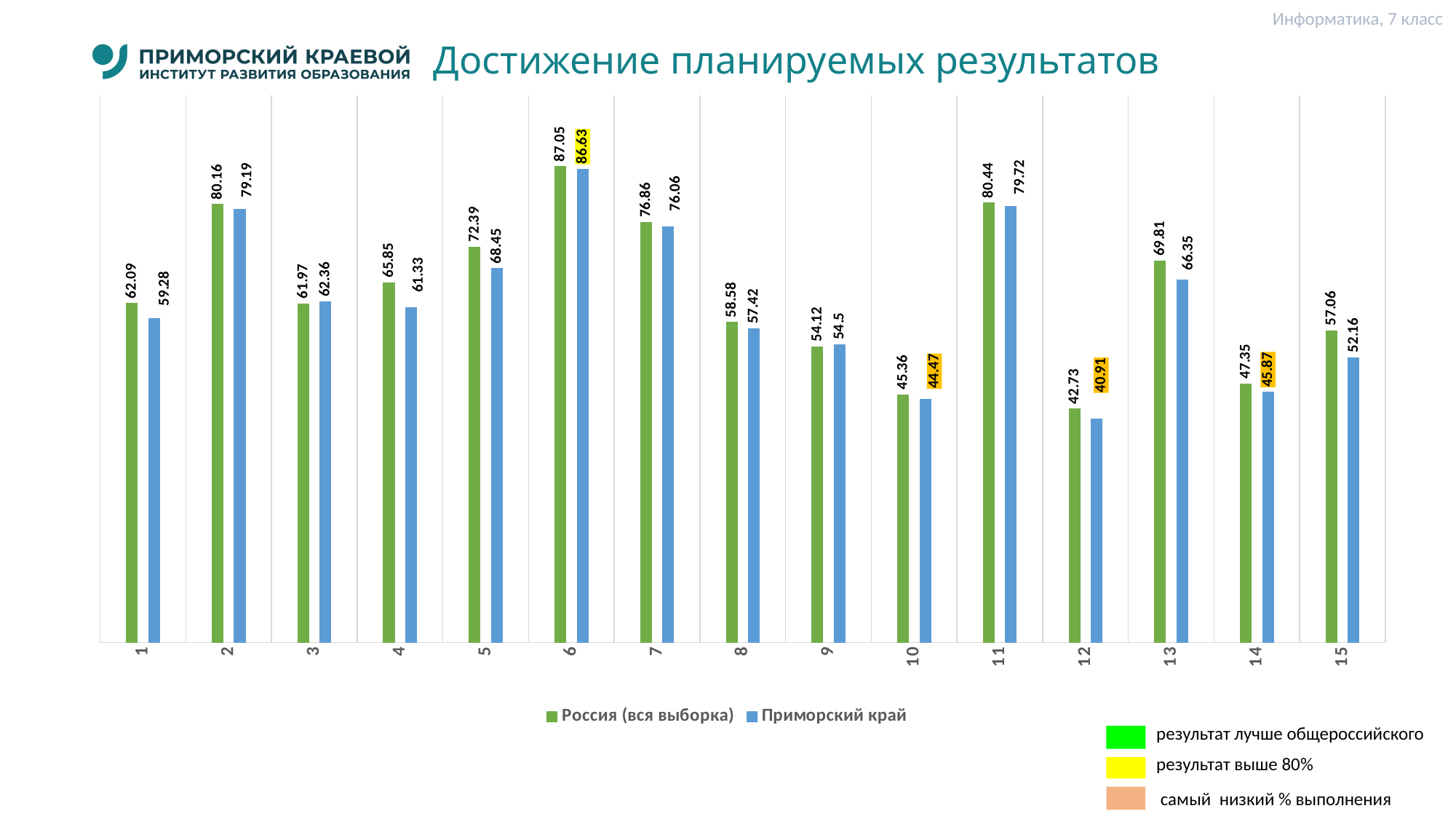
Which task has the lowest value for Приморский край? 12 What is the difference between the Россия (вся выборка) and Приморский край values for task 4? 4.52 What is the value for Россия (вся выборка) for task 13? 69.81 How many series does the chart legend list? 2 How many tasks (categories) are shown on the x axis? 15 What is the value for Приморский край for task 12? 40.91 What is the difference between the Россия (вся выборка) and Приморский край values for task 15? 4.9 What is the value for Приморский край for task 6? 86.63 What type of chart is shown on the slide? bar chart For task 3, which series has the larger value: Россия (вся выборка) or Приморский край? Приморский край Which task has the highest value for Россия (вся выборка)? 6 Which is larger: the Приморский край value for task 2 or for task 11? task 11